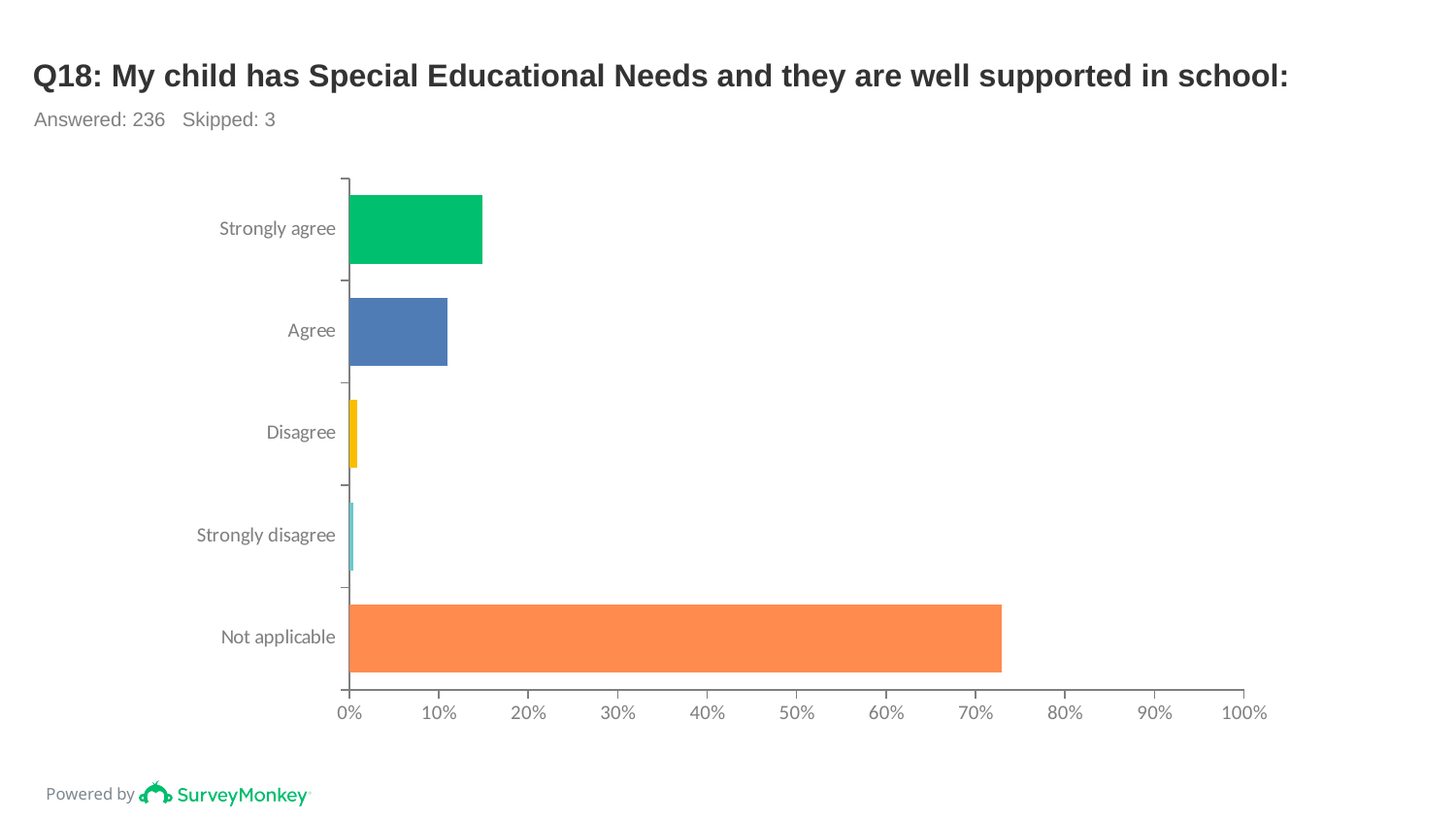
How many respondents answered this question according to the slide? 236 Is the value for Not applicable greater or less than 70%? greater Which response category has the lowest value? Strongly disagree How many respondents skipped this question according to the slide? 3 Which is larger, the value for Strongly agree or the value for Agree? Strongly agree Is the value for Strongly agree greater or less than 10%? greater How many response categories are plotted in the chart? 5 Which is larger, the value for Not applicable or the value for Strongly agree? Not applicable Is the value for Agree greater or less than 20%? less What kind of chart is shown on the slide? bar chart Which response category has the highest value? Not applicable